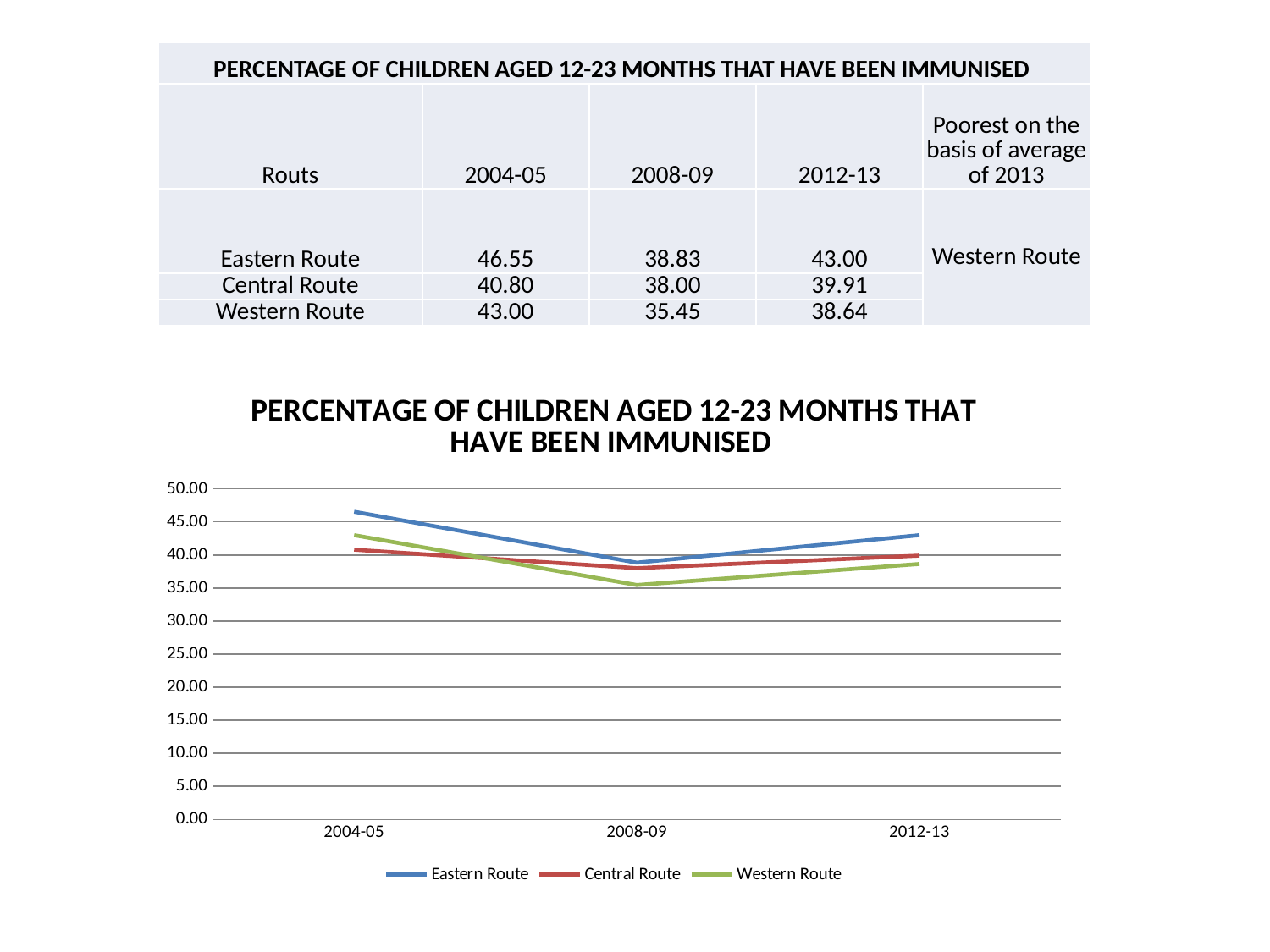
According to the slide, what is the value for Central Route in 2012-13? 39.91 Which route has the lowest value in 2008-09? Western Route According to the slide, what is the value for Western Route in 2008-09? 35.45 Which route has the highest value in 2004-05? Eastern Route According to the slide, what is the value for Eastern Route in 2004-05? 46.55 Which colour is used for the Western Route line in the chart? green How many time periods are plotted along the x axis of the chart? 3 How many series does the chart legend list? 3 What kind of chart is shown on the slide? line chart What is the difference between the Eastern Route and Western Route values in 2012-13? 4.36 Is the value for Western Route in 2008-09 greater or less than 40.00? less Does the Eastern Route line rise or fall from 2004-05 to 2008-09? fall